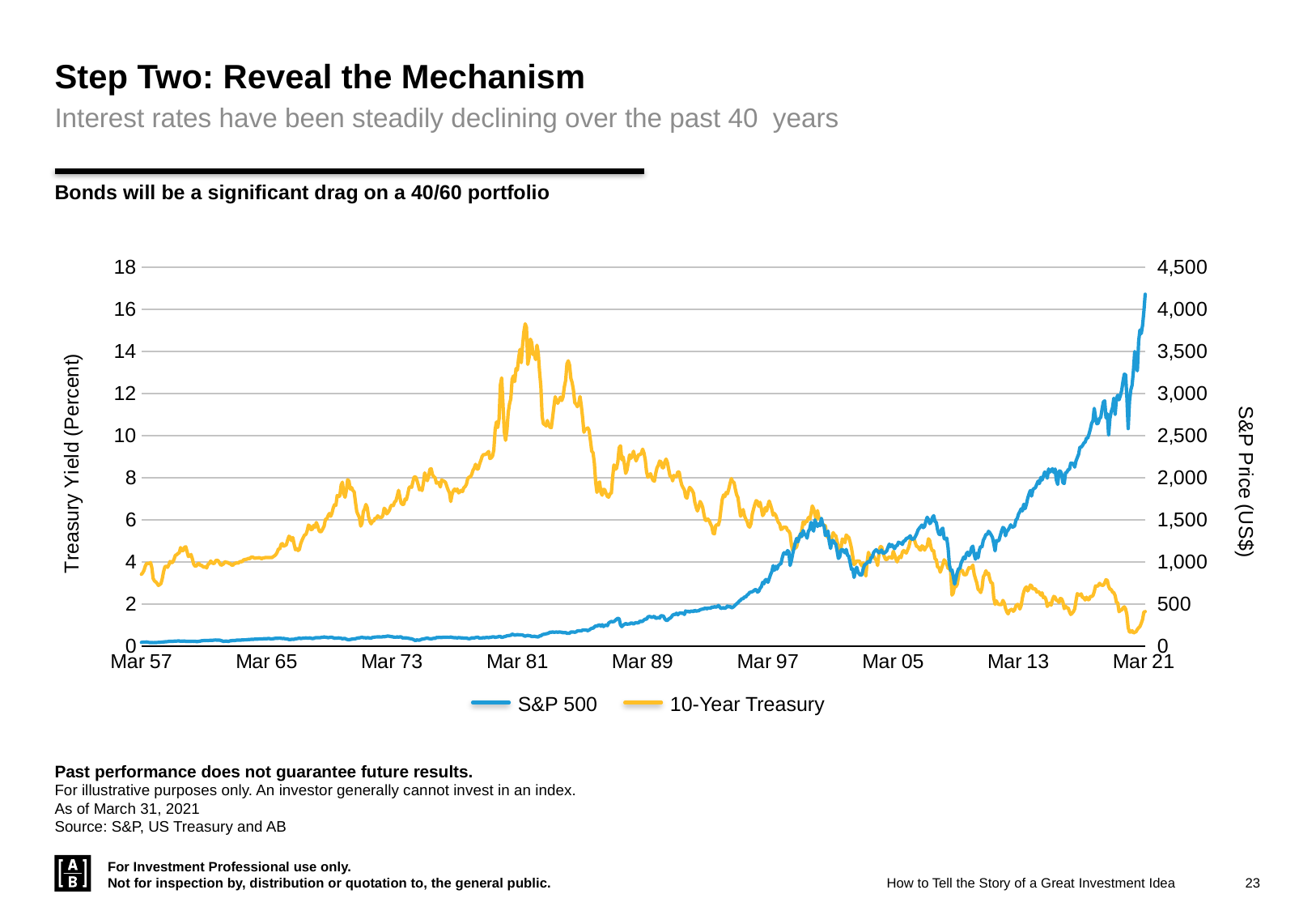
Does the 10-Year Treasury yield generally rise or fall from Mar 81 to Mar 21? fall Is the 10-Year Treasury yield around Mar 81 greater or less than 12? greater How many date labels are shown on the x axis? 9 How many series does the legend list? 2 Is the S&P 500 price at Mar 57 greater or less than 500? less Does the S&P 500 line generally rise or fall from Mar 57 to Mar 21? rise What are the two series named in the legend? S&P 500 and 10-Year Treasury What kind of chart is shown on the slide? line chart What is the highest value shown on the right-hand S&P Price axis? 4,500 What is the title of the left vertical axis? Treasury Yield (Percent) Is the 10-Year Treasury yield at Mar 21 greater or less than 4? less